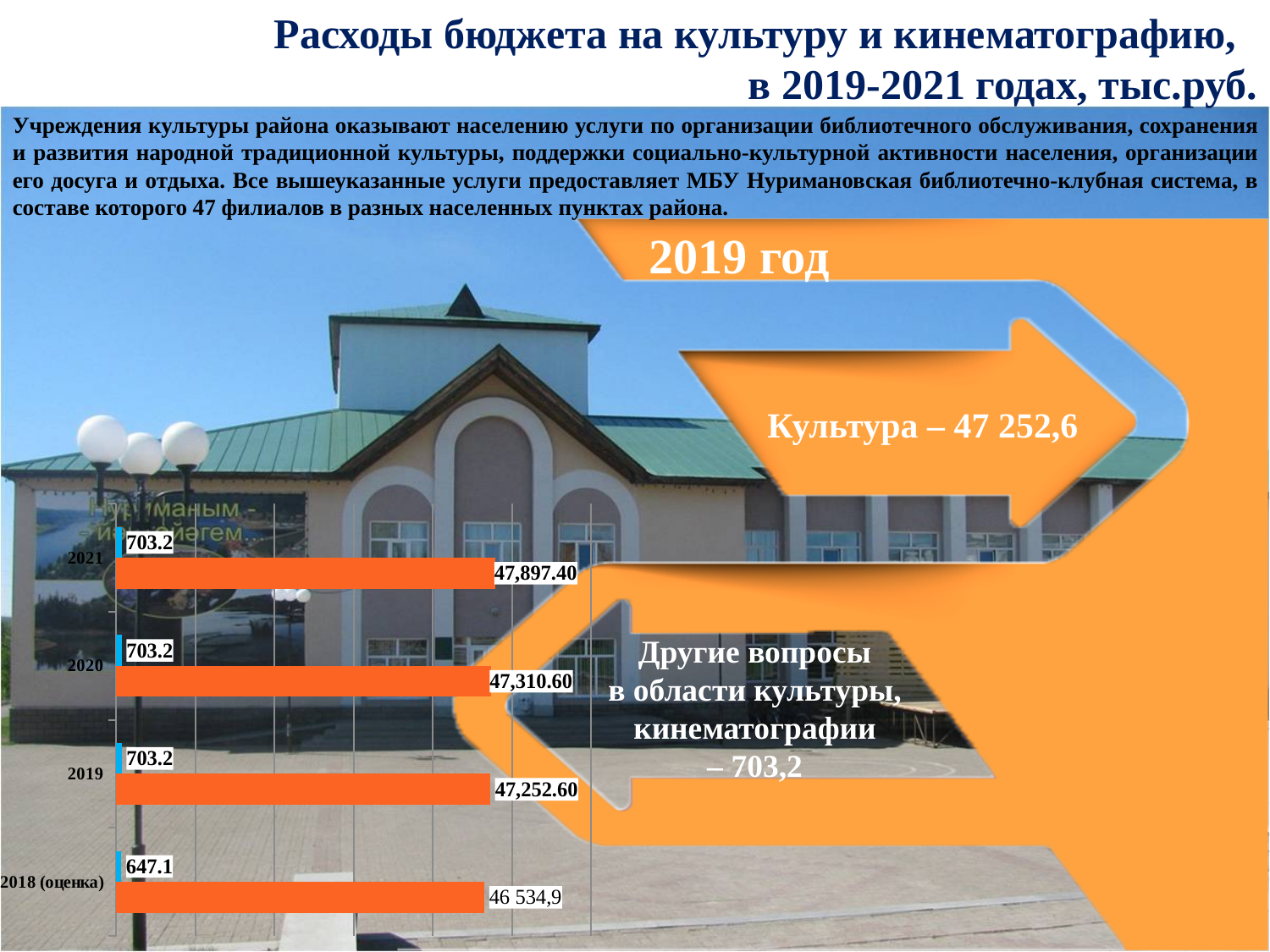
What is the value of the blue bar for 2019? 703.2 Which is larger, the orange bar for 2019 or the orange bar for 2020? 2020 Which year has the highest value for the orange bar? 2021 What type of chart is shown on the slide? bar chart What is the value of the orange bar for 2020? 47,310.60 What is the value of the orange bar for 2018 (оценка)? 46 534,9 What is the value of the orange bar for 2019? 47,252.60 What is the value of the orange bar for 2021? 47,897.40 Which year has the lowest value for the blue bar? 2018 (оценка) How many categories (years) are shown on the chart? 4 What is the difference between the orange bar values for 2021 and 2020? 586.80 What is the value of the blue bar for 2018 (оценка)? 647.1